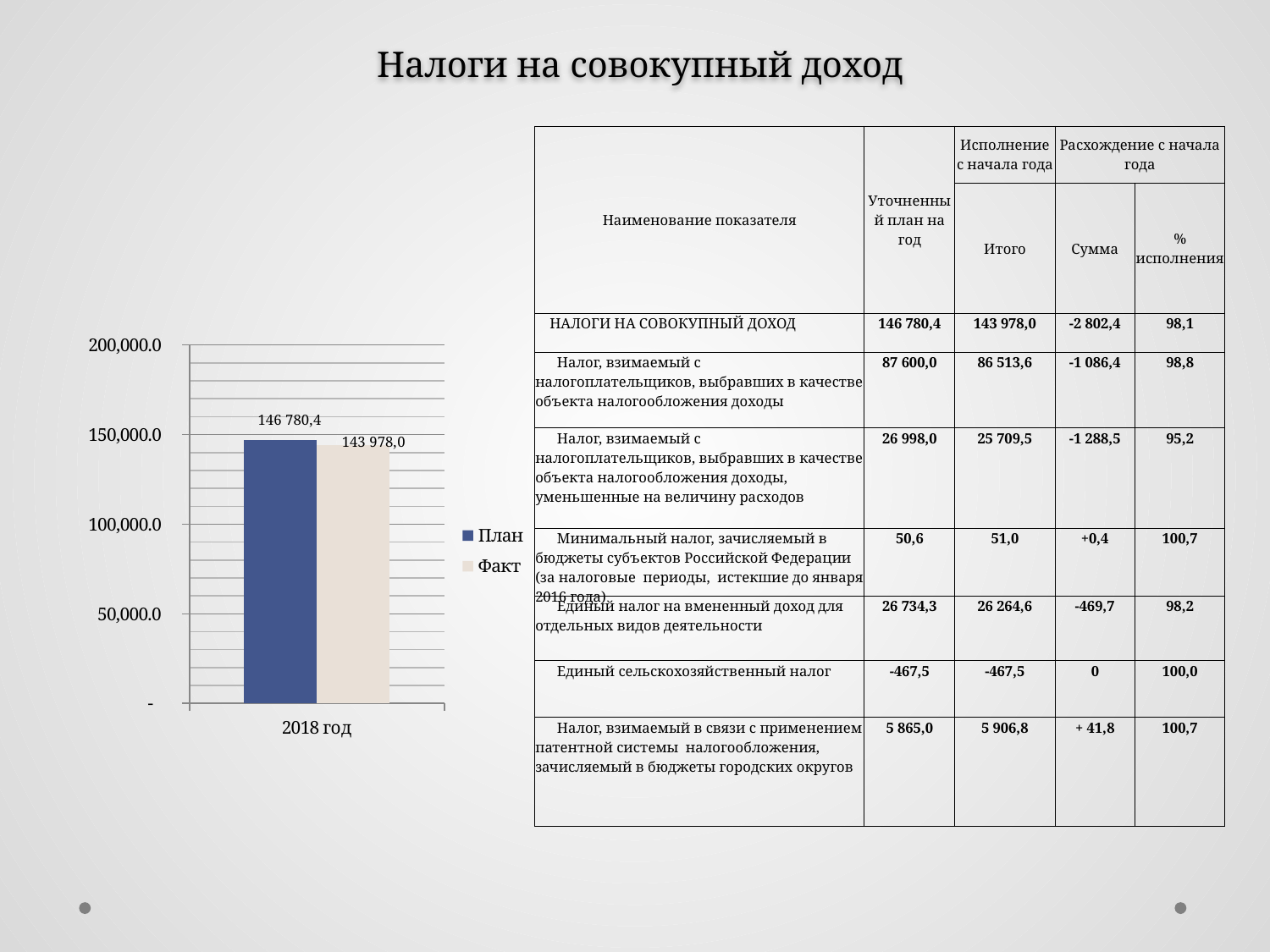
Which series has the lowest value in the chart? Факт What is the value of the План bar for 2018 год? 146 780,4 Which series has the higher value for 2018 год, План or Факт? План What is the value of the Факт bar for 2018 год? 143 978,0 How many categories are shown on the x axis of the chart? 1 Is the value of the Факт bar for 2018 год greater or less than 150,000.0? less What is the difference between the План and Факт values for 2018 год? 2 802,4 Is the value of the План bar for 2018 год greater or less than 100,000.0? greater What category label is shown on the x axis of the chart? 2018 год What type of chart is shown on the slide? bar chart What is the highest value shown on the chart's vertical axis? 200,000.0 How many series does the chart legend list? 2